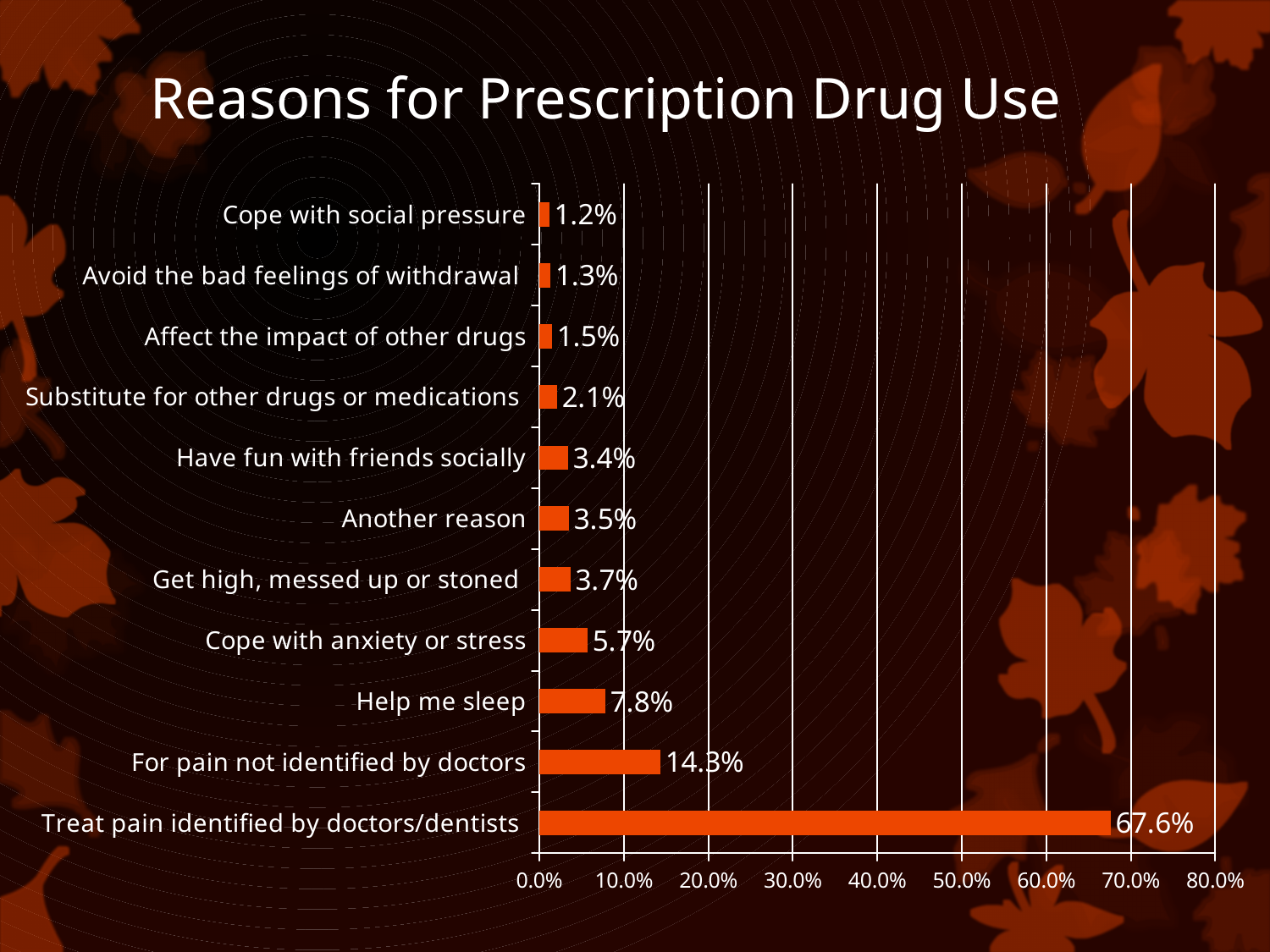
What kind of chart is shown on the slide? Bar chart What is the value for "Help me sleep"? 7.8% Is the value for "Treat pain identified by doctors/dentists" greater or less than 60.0%? greater What is the value for "Substitute for other drugs or medications"? 2.1% How many reasons are shown in the chart? 11 What is the value for "Cope with anxiety or stress"? 5.7% What is the difference between the values for "Help me sleep" and "Cope with anxiety or stress"? 2.1% Which reason has the highest value? Treat pain identified by doctors/dentists What is the title of the chart? Reasons for Prescription Drug Use What is the value for "Treat pain identified by doctors/dentists"? 67.6% Which reason has the lowest value? Cope with social pressure Which is larger, the value for "Get high, messed up or stoned" or the value for "Have fun with friends socially"? Get high, messed up or stoned